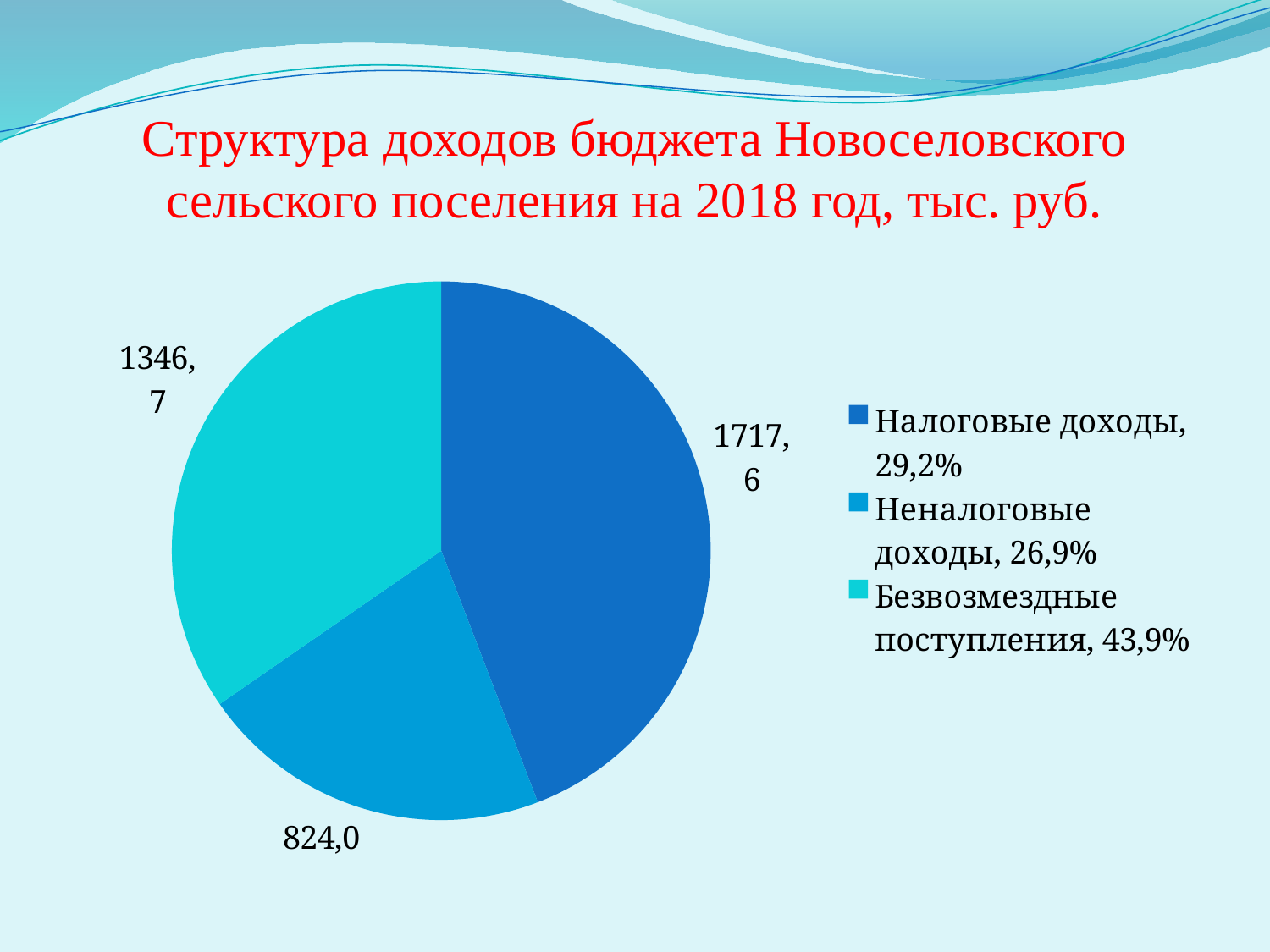
Which category has the largest value in the pie chart? Налоговые доходы What is the total of the three values shown on the pie chart? 3888,3 What type of chart is shown on the slide? Pie chart What is the value shown for Неналоговые доходы? 824,0 What is the value shown for Налоговые доходы? 1717,6 What is the value shown for Безвозмездные поступления? 1346,7 How many slices does the pie chart have? 3 Which is larger, the value for Безвозмездные поступления or the value for Неналоговые доходы? Безвозмездные поступления What is the difference between the values for Налоговые доходы and Неналоговые доходы? 893,6 Which category has the smallest value in the pie chart? Неналоговые доходы How many entries does the legend list? 3 What percentage does the legend show next to Безвозмездные поступления? 43,9%